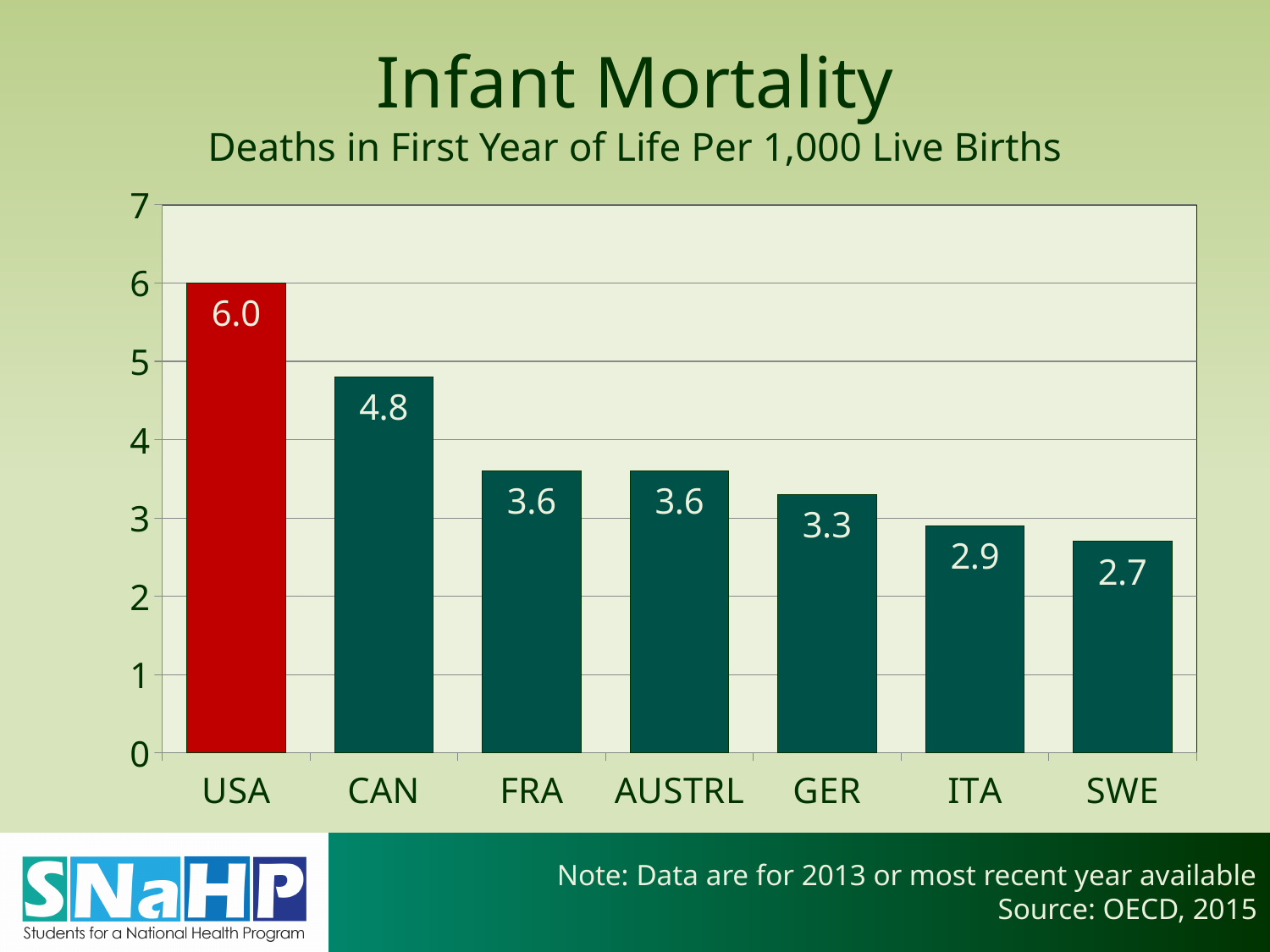
How many countries are shown in the chart? 7 What is the difference between the USA and SWE values? 3.3 Is the value for CAN greater or less than 4? greater Which bar is coloured red rather than dark green? USA Which country has the lowest infant mortality rate? SWE Which country has the highest infant mortality rate? USA What kind of chart is shown on the slide? Bar chart Which has a higher infant mortality rate, CAN or GER? CAN What is the infant mortality value for USA? 6.0 What is the infant mortality value for GER? 3.3 What is the difference between the USA and CAN values? 1.2 What is the infant mortality value for ITA? 2.9